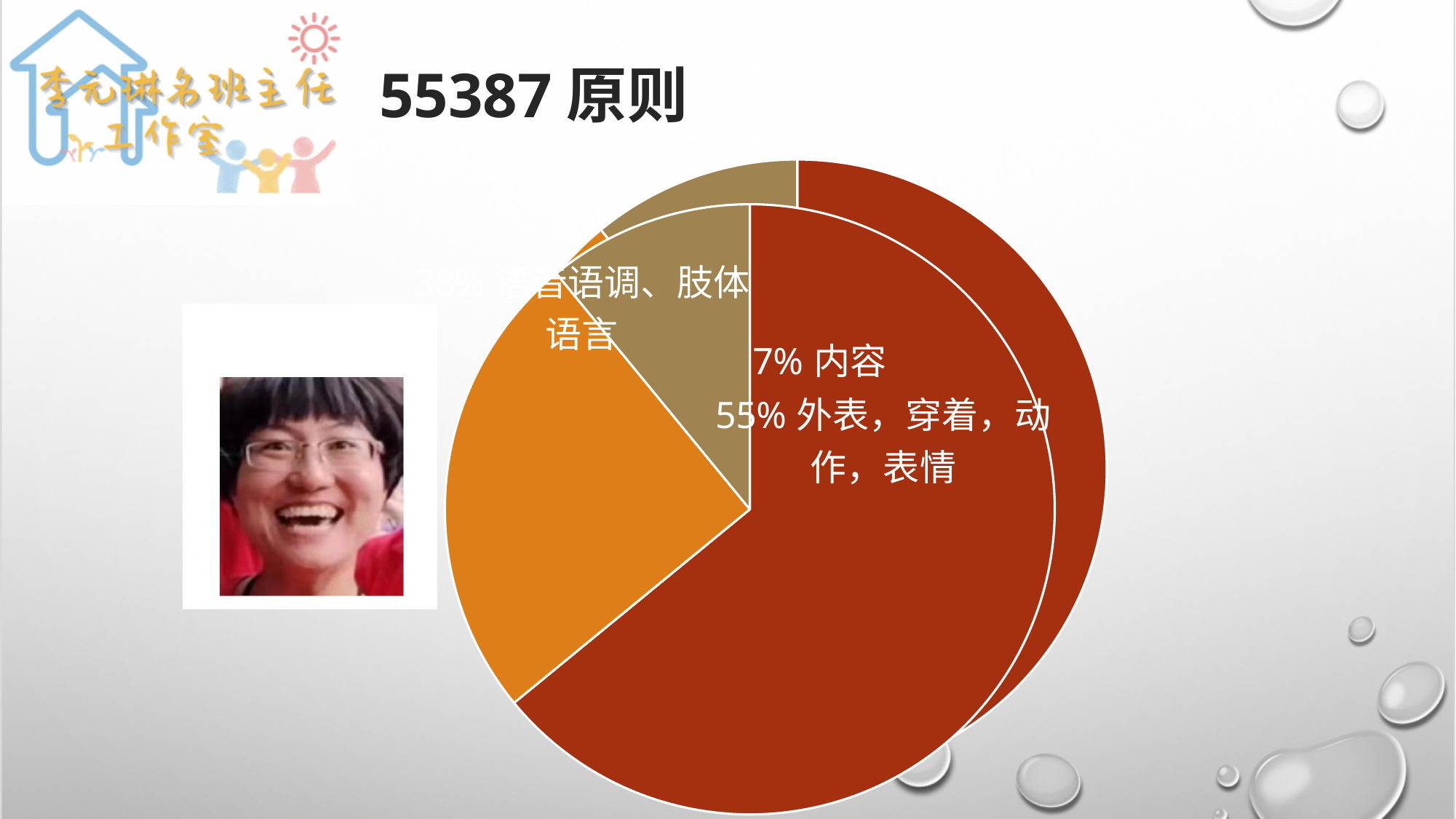
How many slices does the pie chart have? 3 What is the combined percentage of the 语音语调、肢体语言 and 内容 slices? 45% What is the difference in percentage points between the 外表，穿着，动作，表情 slice and the 语音语调、肢体语言 slice? 17 What colour is the 内容 slice in the pie chart? tan (light brown) What percentage does the pie chart give for 语音语调、肢体语言? 38% Which slice of the pie chart is the smallest? 内容 Which is larger in the pie chart, 语音语调、肢体语言 or 内容? 语音语调、肢体语言 What kind of chart is shown on the slide? pie chart What percentage does the pie chart give for 外表，穿着，动作，表情? 55% Which slice of the pie chart is the largest? 外表，穿着，动作，表情 What percentage does the pie chart give for 内容? 7% What is the title of the slide containing the pie chart? 55387 原则